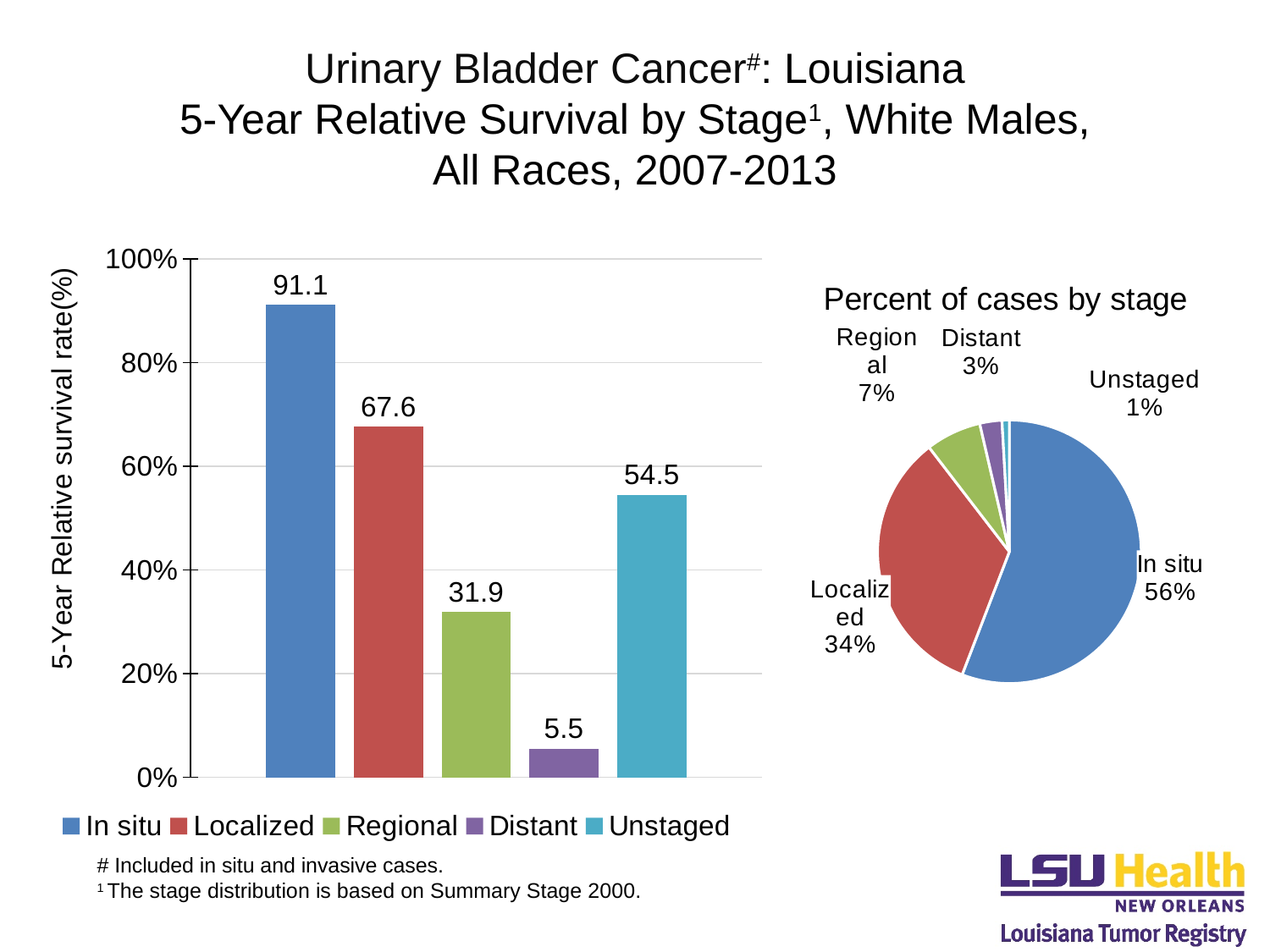
In the bar chart on the left, what is the 5-year relative survival rate for the Localized stage? 67.6 What type of chart is the 'Percent of cases by stage' chart on the right? Pie chart How many entries does the legend of the bar chart on the left list? 5 In the bar chart on the left, what is the difference between the survival rates for In situ and Localized? 23.5 In the bar chart on the left, which has a higher survival rate, Regional or Unstaged? Unstaged In the bar chart on the left, which stage has the highest 5-year relative survival rate? In situ In the bar chart on the left, what is the 5-year relative survival rate for the Unstaged category? 54.5 How many bars are shown in the bar chart on the left? 5 In the 'Percent of cases by stage' pie chart, what share of cases is Localized? 34% In the bar chart on the left, which stage has the lowest 5-year relative survival rate? Distant In the 'Percent of cases by stage' pie chart, which stage has the largest share of cases? In situ In the bar chart on the left, is the value for Regional greater or less than 40%? less